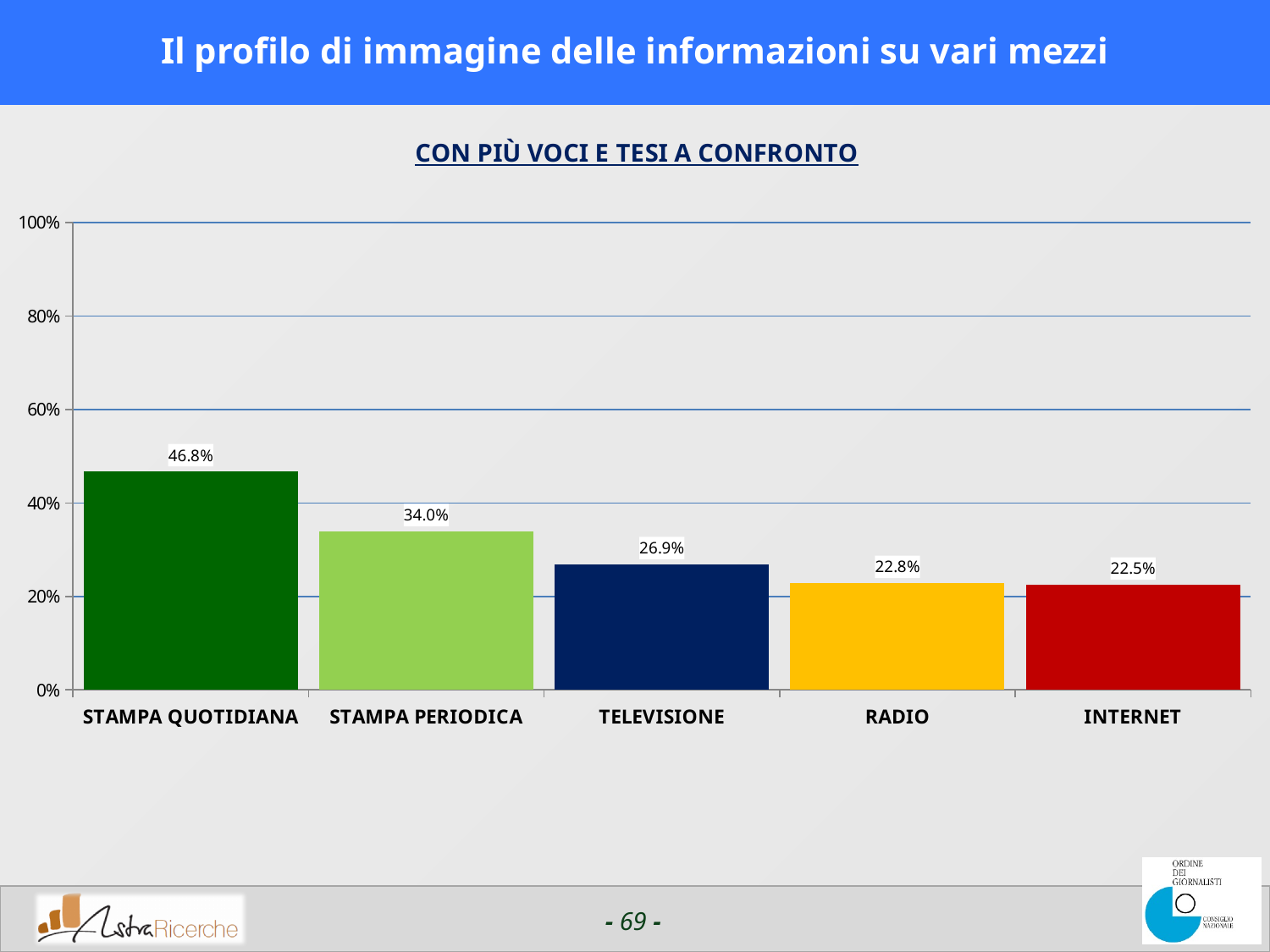
What is the value for TELEVISIONE? 26.9% Is the value for STAMPA QUOTIDIANA greater or less than 40%? greater What is the difference between the values for STAMPA QUOTIDIANA and STAMPA PERIODICA? 12.8% What is the value for INTERNET? 22.5% What is the title shown above the chart? CON PIÙ VOCI E TESI A CONFRONTO Which category has the highest value? STAMPA QUOTIDIANA Which category has the lowest value? INTERNET What is the difference between the values for RADIO and INTERNET? 0.3% What kind of chart is shown on the slide? bar chart What is the value for STAMPA QUOTIDIANA? 46.8% How many categories are shown on the x axis? 5 Which is larger, the value for STAMPA PERIODICA or the value for TELEVISIONE? STAMPA PERIODICA